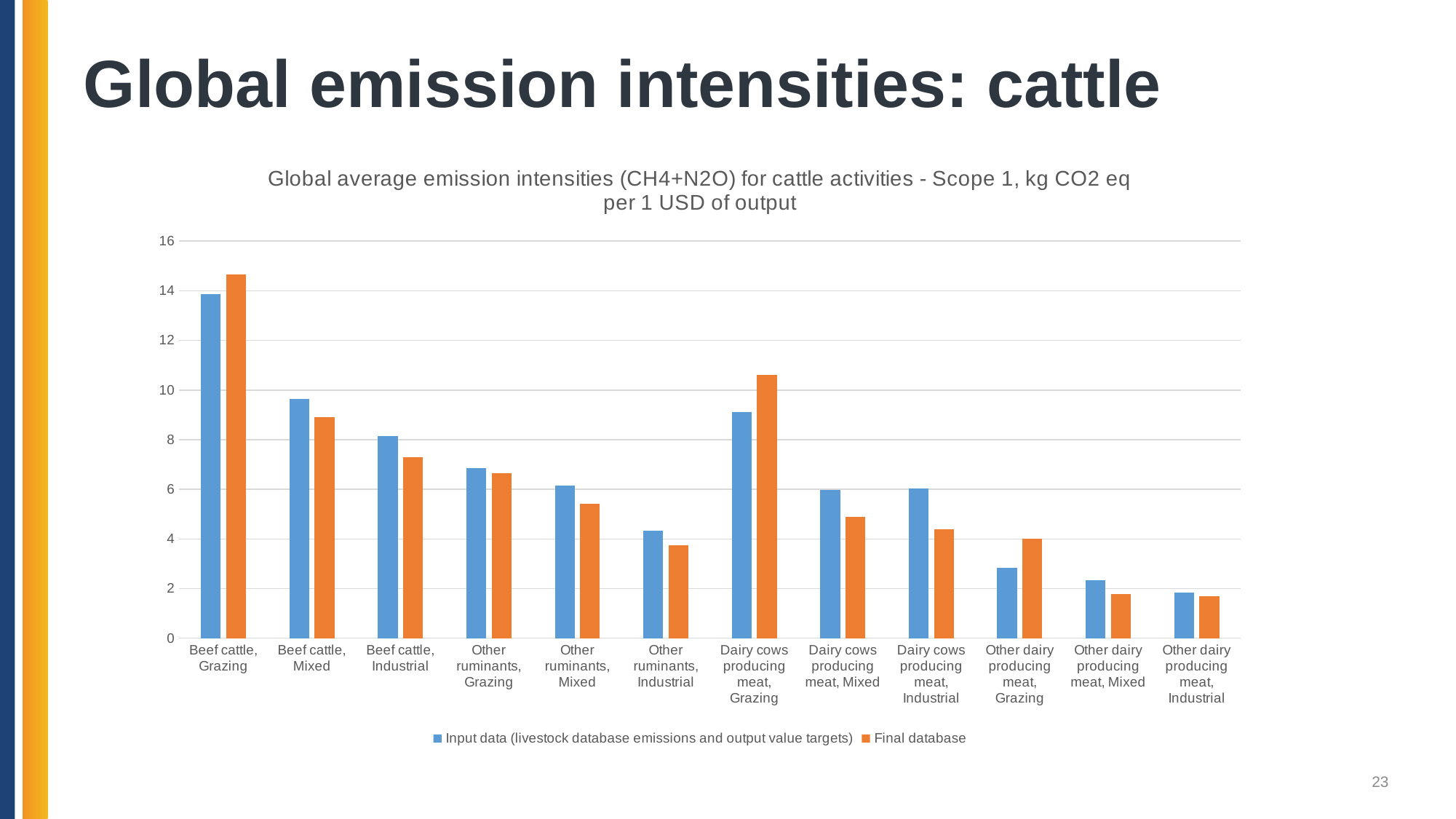
Which category has the highest Final database value? Beef cattle, Grazing Is the Final database value for Other dairy producing meat, Grazing greater or less than 2? greater For Dairy cows producing meat, Grazing, which is larger: the Input data value or the Final database value? Final database How many series does the legend list? 2 Which colour represents the Final database series? orange For Beef cattle, Mixed, which is larger: the Input data value or the Final database value? Input data How many cattle activity categories are shown on the x axis? 12 Is the Final database value for Beef cattle, Grazing greater or less than 14? greater Is the Input data value for Dairy cows producing meat, Grazing greater or less than 10? less Which category has the highest Input data value? Beef cattle, Grazing What kind of chart is shown on the slide? bar chart Which category has the lowest Input data value? Other dairy producing meat, Industrial